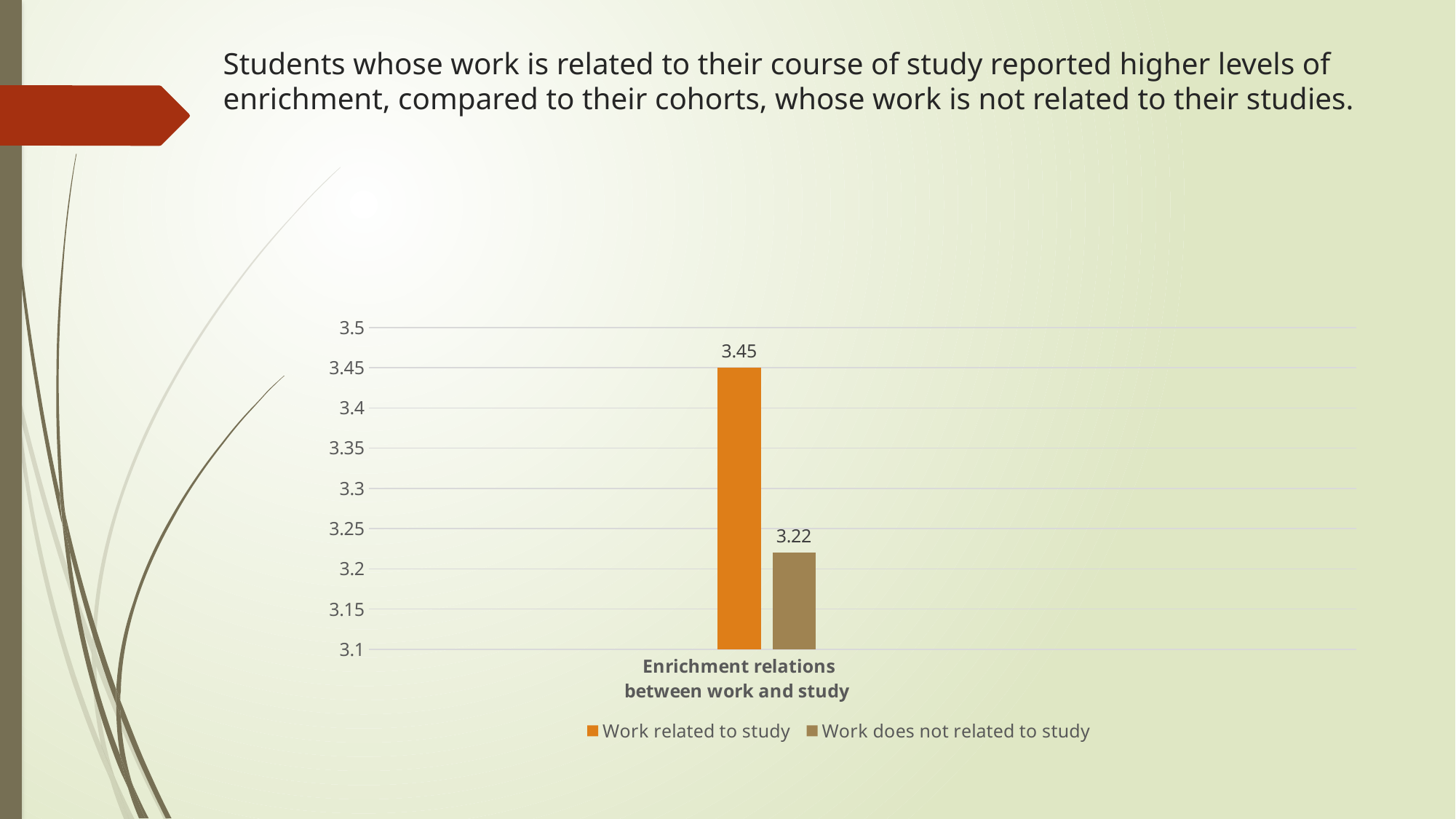
How many categories are shown on the x axis? 1 Is the value for Work related to study larger or smaller than the value for Work does not related to study? larger What is the value for Work related to study? 3.45 Is the value for Work related to study greater or less than 3.4? greater What is the category label on the x axis? Enrichment relations between work and study What kind of chart is shown on the slide? bar chart Which series has the lower value? Work does not related to study Is the value for Work does not related to study greater or less than 3.3? less What is the difference between the values for Work related to study and Work does not related to study? 0.23 How many series does the legend list? 2 Which series has the higher value? Work related to study What is the value for Work does not related to study? 3.22